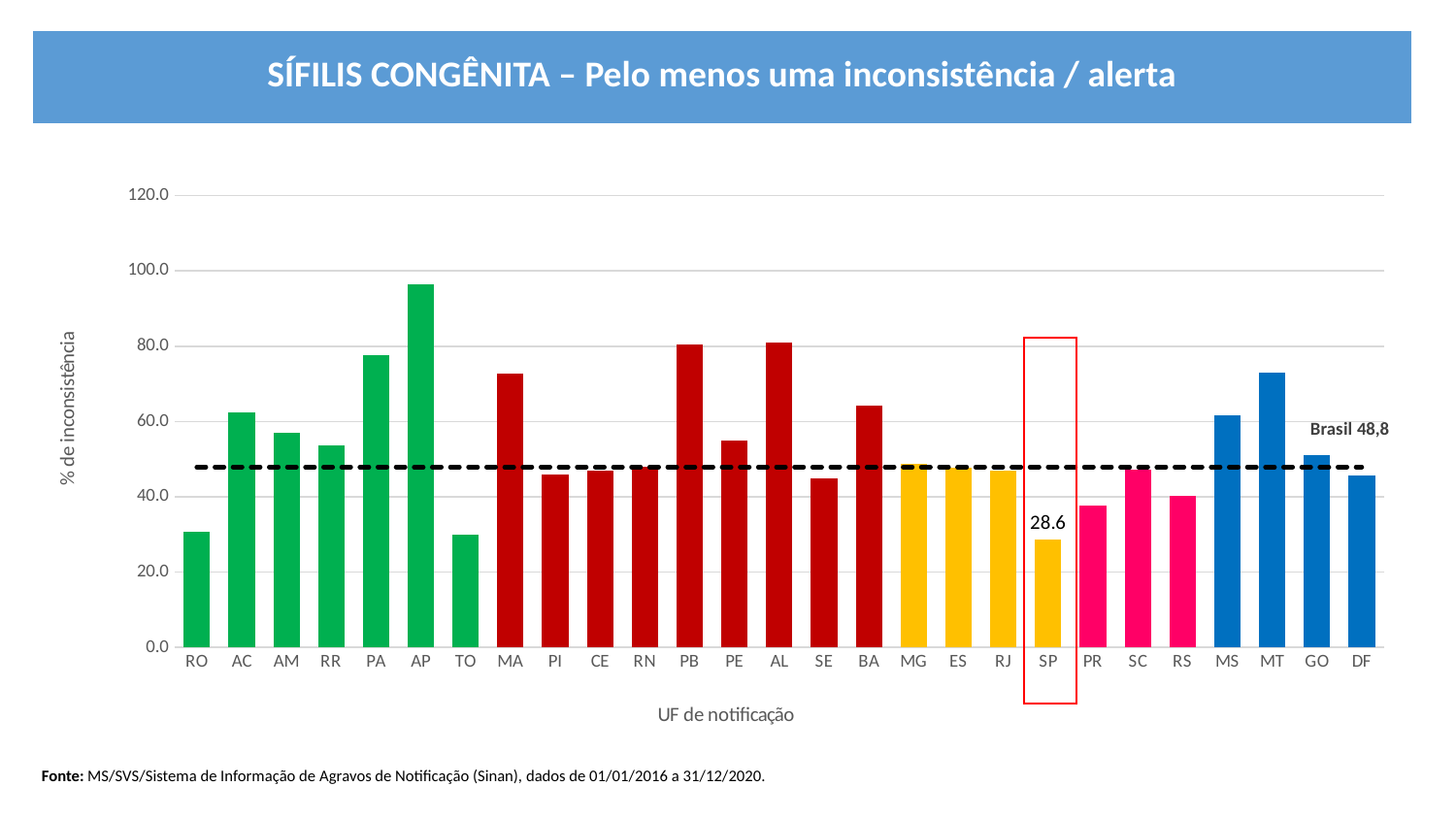
Is the value for AP greater or less than 80? greater What is the label of the x axis? UF de notificação What kind of chart is shown on the slide? bar chart Which UF has the highest % de inconsistência? AP Is the value for MT greater or less than 60? greater Which is larger, the value for AP or the value for MT? AP What value is given for Brasil by the dashed reference line? 48,8 Is the value for RO greater or less than 40? less Which is larger, the value for RO or the value for AC? AC What is the value shown for SP? 28.6 How many UFs (categories) are plotted on the x axis? 27 Which UF has the lowest % de inconsistência? SP